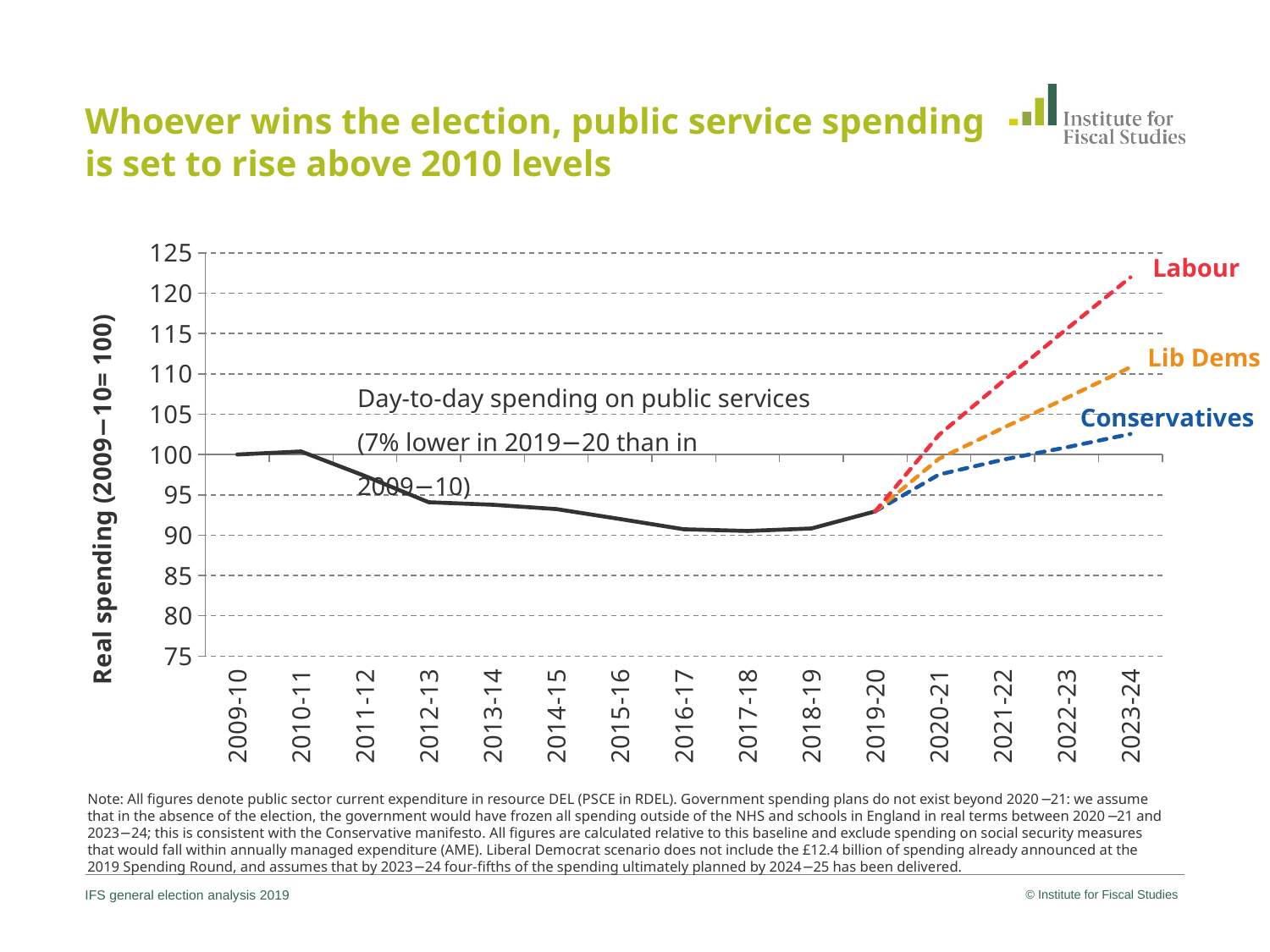
How many party scenarios are labelled on the chart? 3 Do the values rise or fall between 2010-11 and 2017-18? fall How many years are shown along the x axis of the chart? 15 Which party's projection is highest in 2023-24? Labour What is the value of real spending in 2009-10, the base year of the index? 100 Which party's projection is lowest in 2023-24? Conservatives Is the Conservatives projection for 2023-24 greater or less than 100? greater In 2023-24, is the Labour projection or the Conservatives projection larger? Labour What kind of chart is shown on the slide? line chart Is the Labour projection for 2023-24 greater or less than 120? greater Is the value for 2017-18 greater or less than 95? less According to the annotation on the chart, by what percentage was spending lower in 2019-20 than in 2009-10? 7%